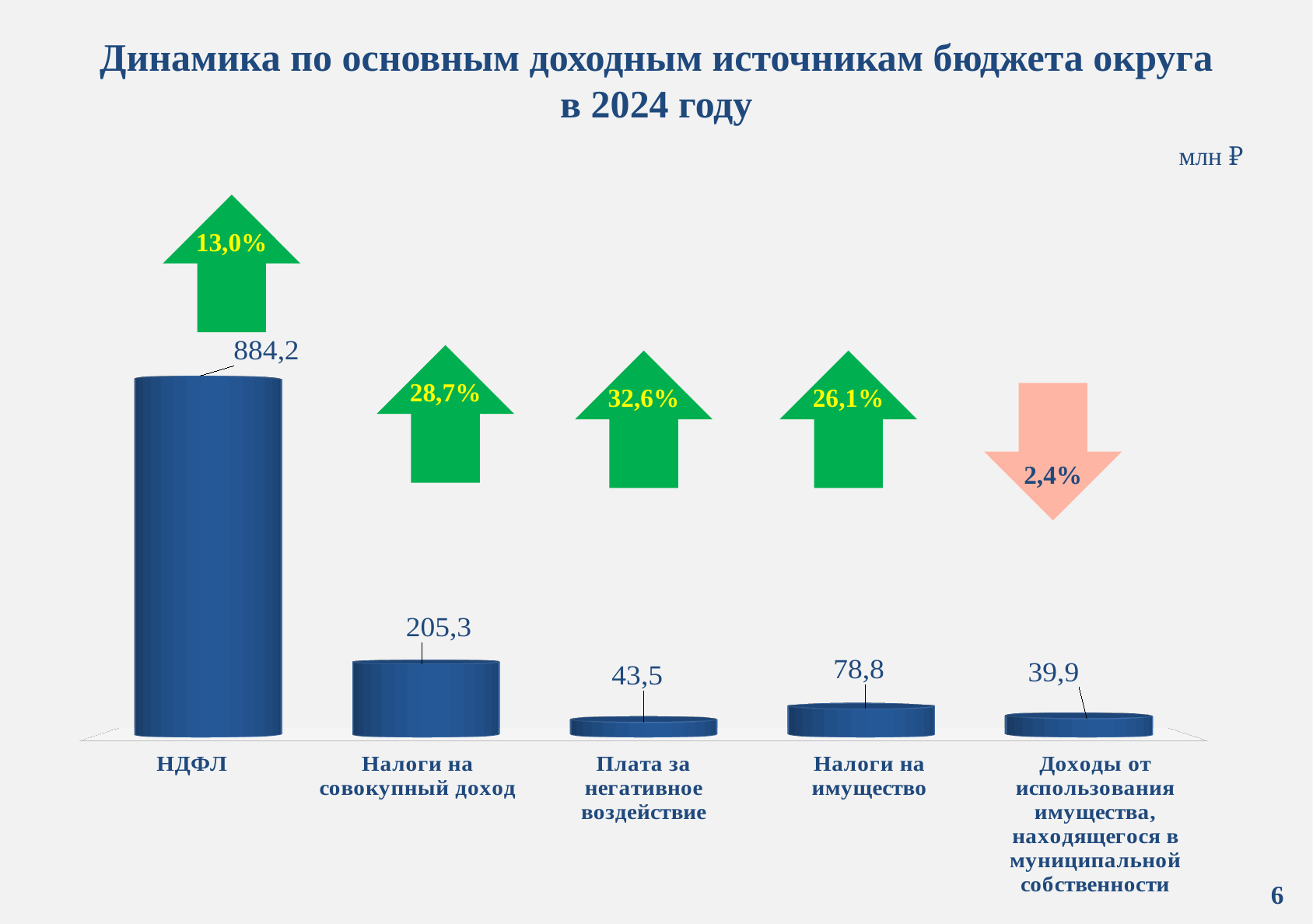
Which category has the highest value? НДФЛ What is the value for Доходы от использования имущества, находящегося в муниципальной собственности? 39,9 Which category has the lowest value? Доходы от использования имущества, находящегося в муниципальной собственности What is the value for Плата за негативное воздействие? 43,5 What is the value for НДФЛ? 884,2 What kind of chart is shown on the slide? Bar chart Which is larger: the value for Налоги на имущество or the value for Плата за негативное воздействие? Налоги на имущество What is the value for Налоги на имущество? 78,8 What is the difference between the values for Налоги на имущество and Плата за негативное воздействие? 35,3 What is the value for Налоги на совокупный доход? 205,3 What is the difference between the values for НДФЛ and Налоги на совокупный доход? 678,9 How many categories are shown in the chart? 5